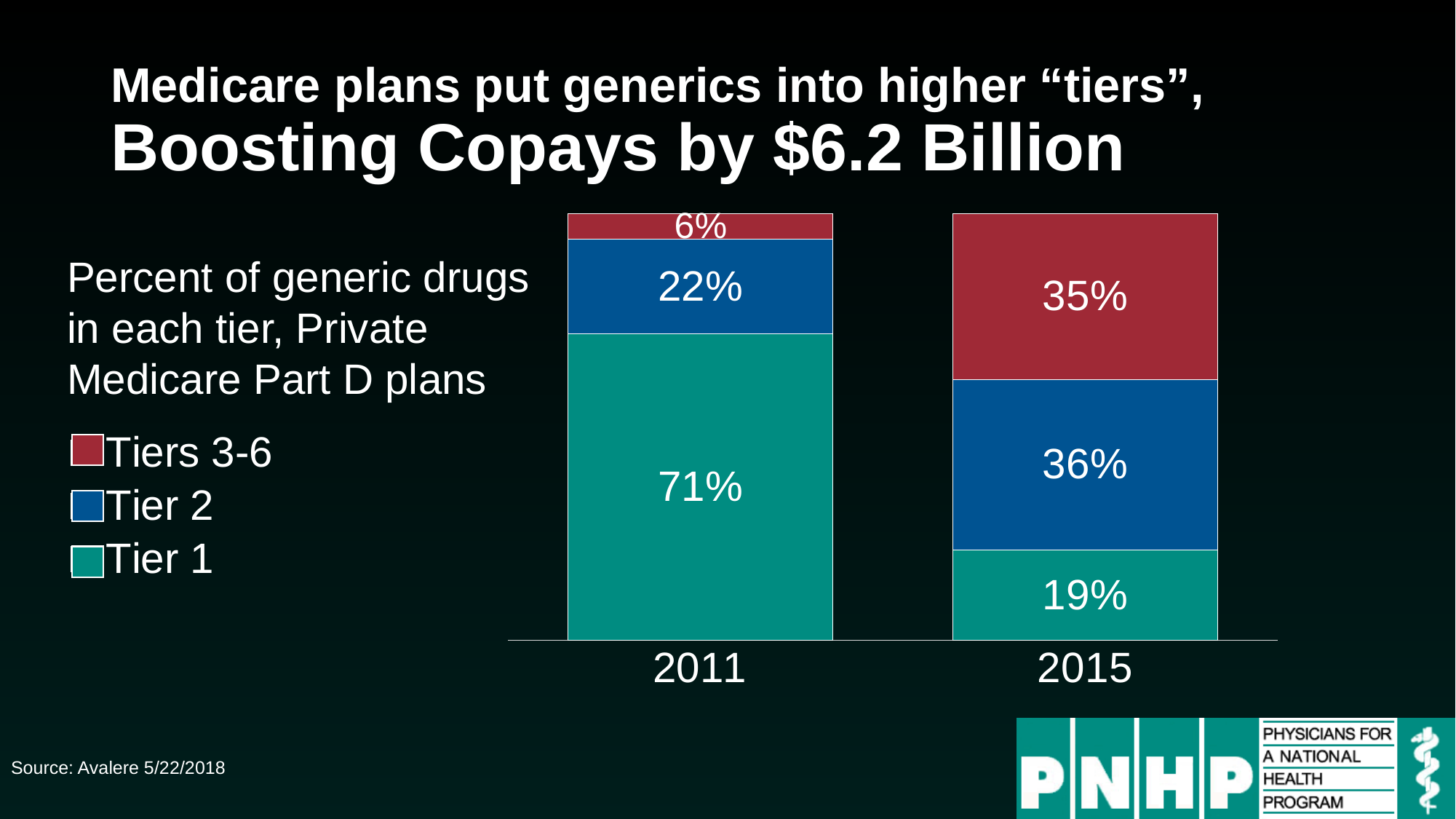
Which is larger: the Tiers 3-6 share in 2011 or in 2015? 2015 What percent of generic drugs were in Tier 1 in 2011? 71% Which colour represents Tier 2 in the chart? Blue What percent of generic drugs were in Tier 2 in 2015? 36% Which tier had the largest share of generic drugs in 2011? Tier 1 How many series does the legend list? 3 What percent of generic drugs were in Tier 1 in 2015? 19% Which tier had the smallest share of generic drugs in 2015? Tier 1 How many years are shown on the x axis? 2 What kind of chart is shown on the slide? Stacked bar chart By how many percentage points did the Tier 1 share fall from 2011 to 2015? 52 What percent of generic drugs were in Tiers 3-6 in 2011? 6%